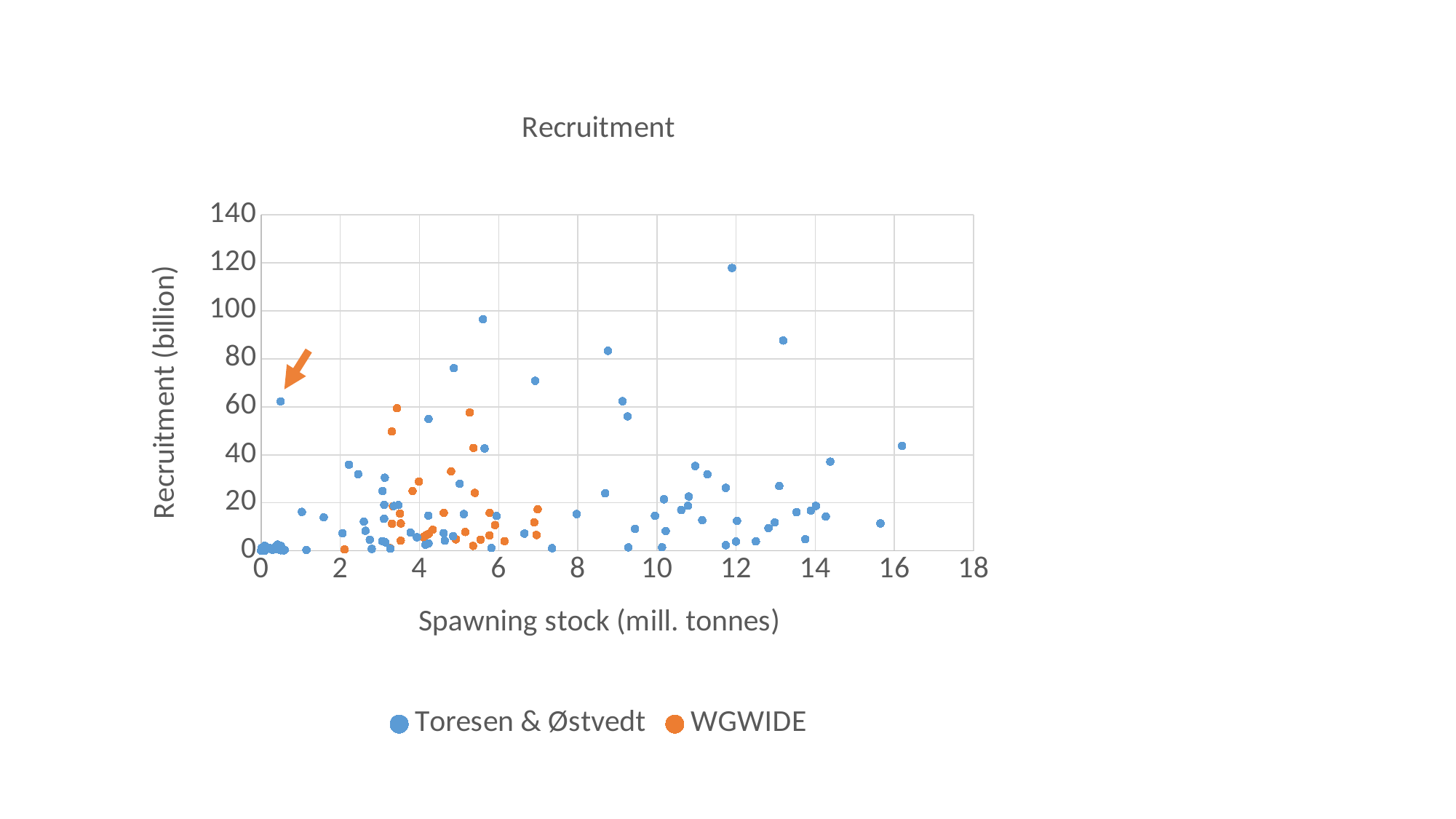
What is the title of the chart? Recruitment Is the highest recruitment value in the Toresen & Østvedt series greater or less than 100? greater What are the two series named in the legend? Toresen & Østvedt and WGWIDE What kind of chart is shown on the slide? scatter chart Is the highest recruitment value in the WGWIDE series greater or less than 80? less Is the largest spawning stock value among the WGWIDE points greater or less than 8? less Which series contains the point with the highest recruitment value? Toresen & Østvedt Which series extends to larger spawning stock values on the x axis? Toresen & Østvedt How many series does the legend list? 2 What is the highest value shown on the y axis? 140 What is the highest value shown on the x axis? 18